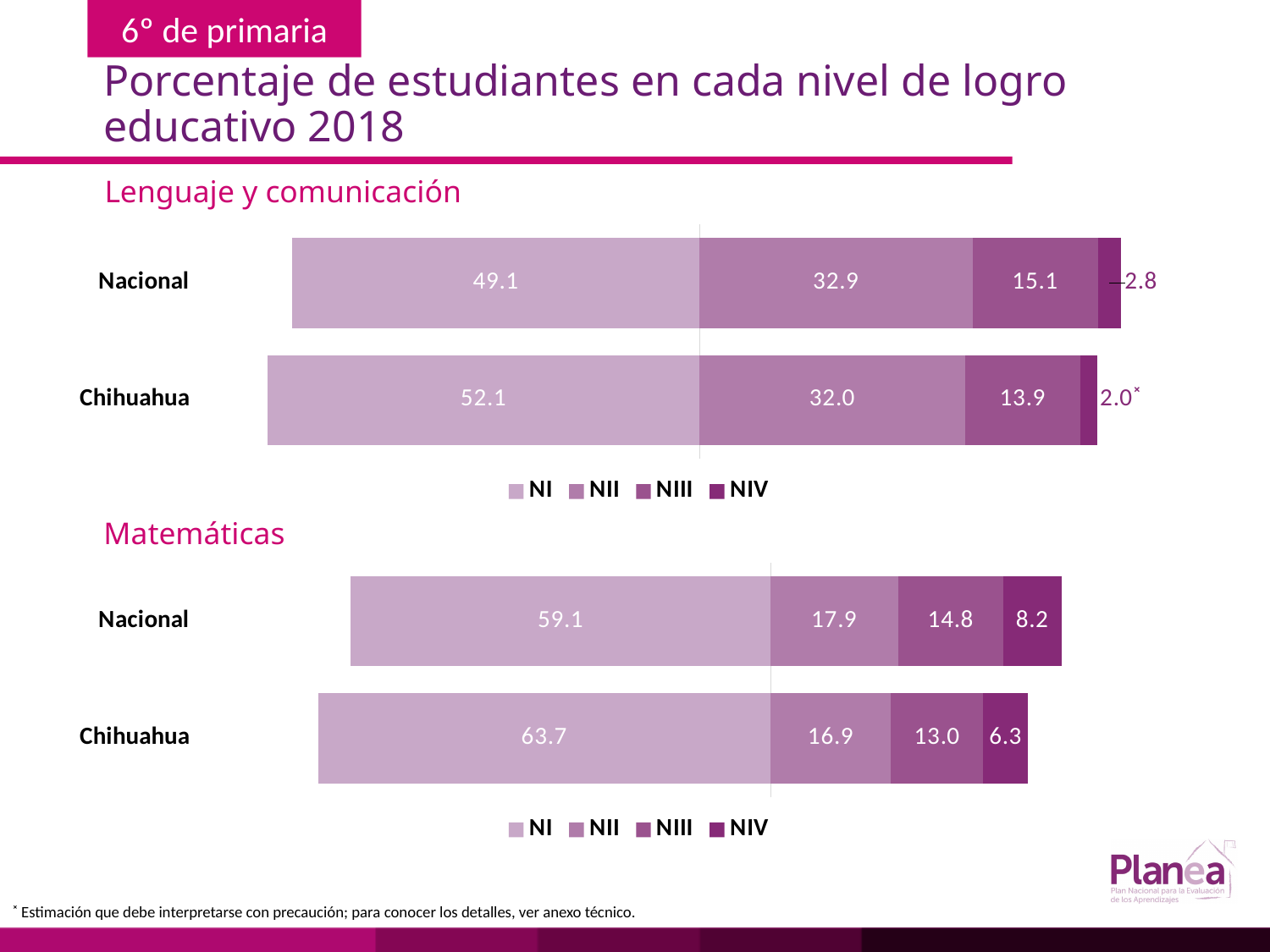
In the Lenguaje y comunicación chart, which level has the lowest value for Nacional? NIV How many categories are shown in the Lenguaje y comunicación chart? 2 In the Lenguaje y comunicación chart, what is the NIV value for Nacional? 2.8 In the Matemáticas chart, what is the NII value for Chihuahua? 16.9 In the Lenguaje y comunicación chart, which is larger: the NIII value for Nacional or for Chihuahua? Nacional In the Matemáticas chart, what is the NIII value for Nacional? 14.8 What kind of chart is the Matemáticas chart? Stacked bar chart In the Matemáticas chart, what is the difference between the NI values for Chihuahua and Nacional? 4.6 In the Matemáticas chart, which level has the highest value for Chihuahua? NI In the Matemáticas chart, what is the total of the stacked bar for Nacional? 100.0 How many series does the legend of the Matemáticas chart list? 4 In the Lenguaje y comunicación chart, what is the NI value for Chihuahua? 52.1